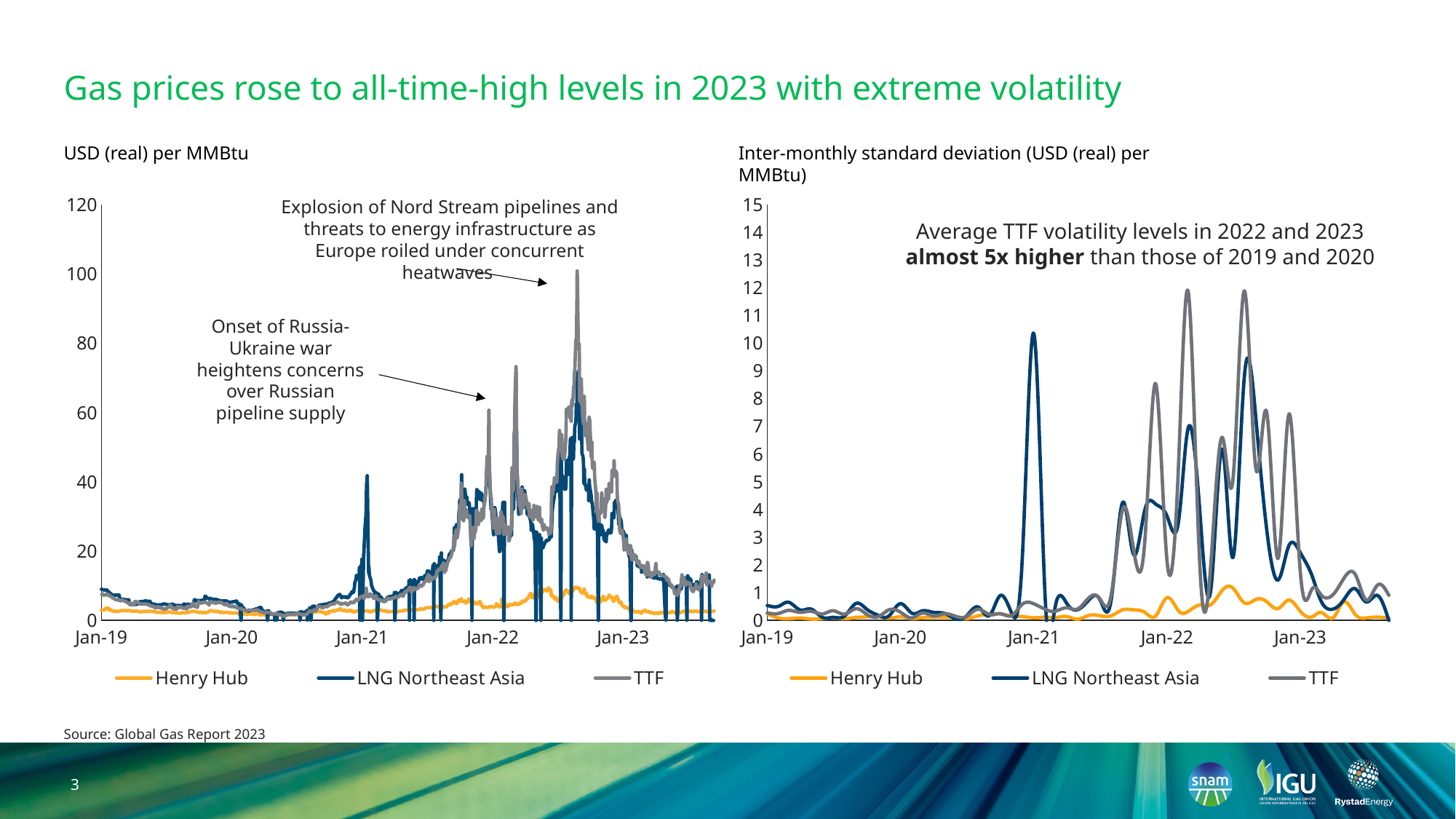
In the right chart (Inter-monthly standard deviation), which series reaches the highest value? TTF In the left chart (USD (real) per MMBtu), do TTF prices rise or fall between their late-2022 peak and Jan-23? fall How many series does the legend of the right chart (Inter-monthly standard deviation) list? 3 What source is cited for the charts on the slide? Global Gas Report 2023 What kind of chart is the left chart titled 'USD (real) per MMBtu'? line chart How many year labels are shown on the x axis of the left chart (USD (real) per MMBtu)? 5 In the left chart (USD (real) per MMBtu), is the highest TTF value in late 2022 greater or less than 80? greater According to the annotation on the right chart, how much higher were average TTF volatility levels in 2022 and 2023 than those of 2019 and 2020? almost 5x higher In the right chart (Inter-monthly standard deviation), is the LNG Northeast Asia peak near Jan-21 greater or less than 8? greater How many series does the legend of the left chart (USD (real) per MMBtu) list? 3 In the left chart (USD (real) per MMBtu), is the highest Henry Hub value greater or less than 20? less In the left chart (USD (real) per MMBtu), which series is higher at Jan-23, TTF or Henry Hub? TTF